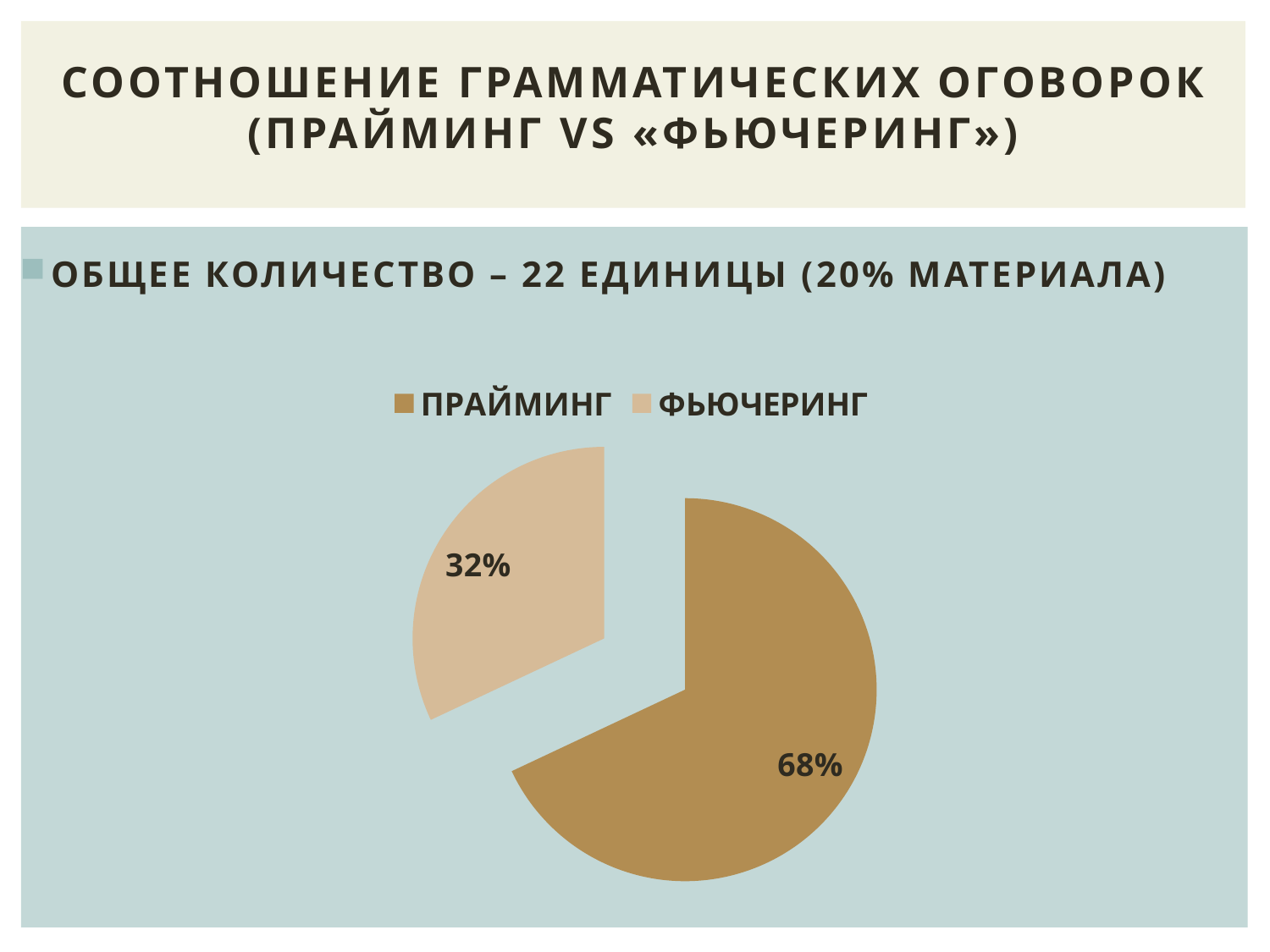
What is the difference in percentage points between the ПРАЙМИНГ and ФЬЮЧЕРИНГ slices? 36 Which slice is the smallest? ФЬЮЧЕРИНГ How many entries does the legend list? 2 What share of the pie does ФЬЮЧЕРИНГ have? 32% Which slice is pulled out (exploded) from the pie? ФЬЮЧЕРИНГ Which slice is the largest? ПРАЙМИНГ Which legend entry is shown in the lighter beige colour? ФЬЮЧЕРИНГ Which is larger, the ПРАЙМИНГ slice or the ФЬЮЧЕРИНГ slice? ПРАЙМИНГ How many slices does the pie chart have? 2 What kind of chart is shown on the slide? pie chart What share of the pie does ПРАЙМИНГ have? 68%